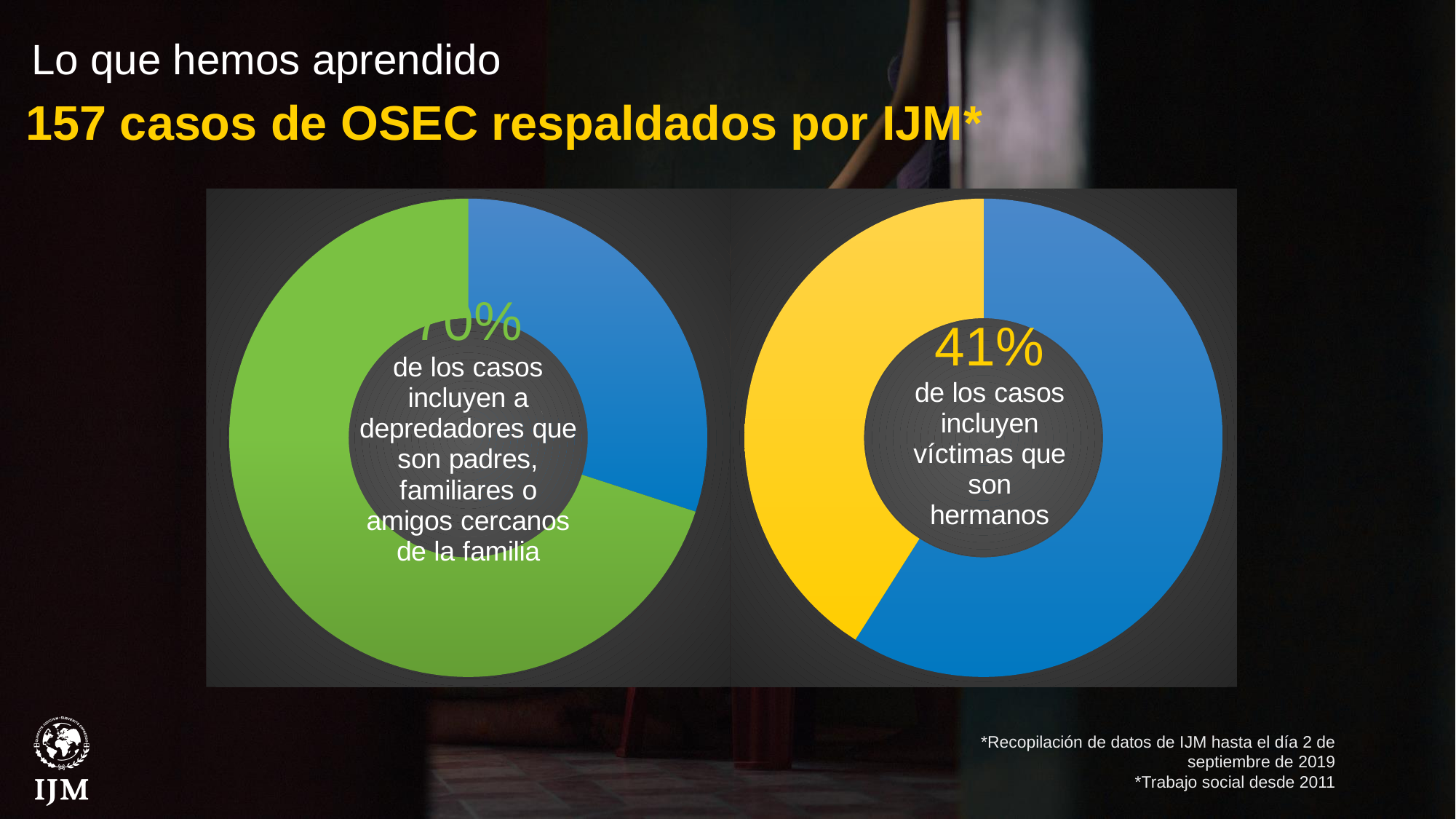
In the left chart, what percentage of cases include predators who are parents, relatives or close family friends? 70% In the right chart, what percentage of cases include victims who are siblings (hermanos)? 41% In the right chart, what share of the pie does the blue slice represent? 59% In the left chart, which slice is larger, the green one or the blue one? green How many charts are shown on the slide? 2 In the right chart, which slice is larger, the yellow one or the blue one? blue What kind of chart is used on this slide? pie chart (donut) According to the slide heading, how many OSEC cases were supported by IJM? 157 How many slices does the right chart have? 2 In the left chart, is the green slice's share greater or less than 50%? greater Which chart shows the larger highlighted percentage, the left chart or the right chart? left chart What colour is the slice representing the 41% in the right chart? yellow